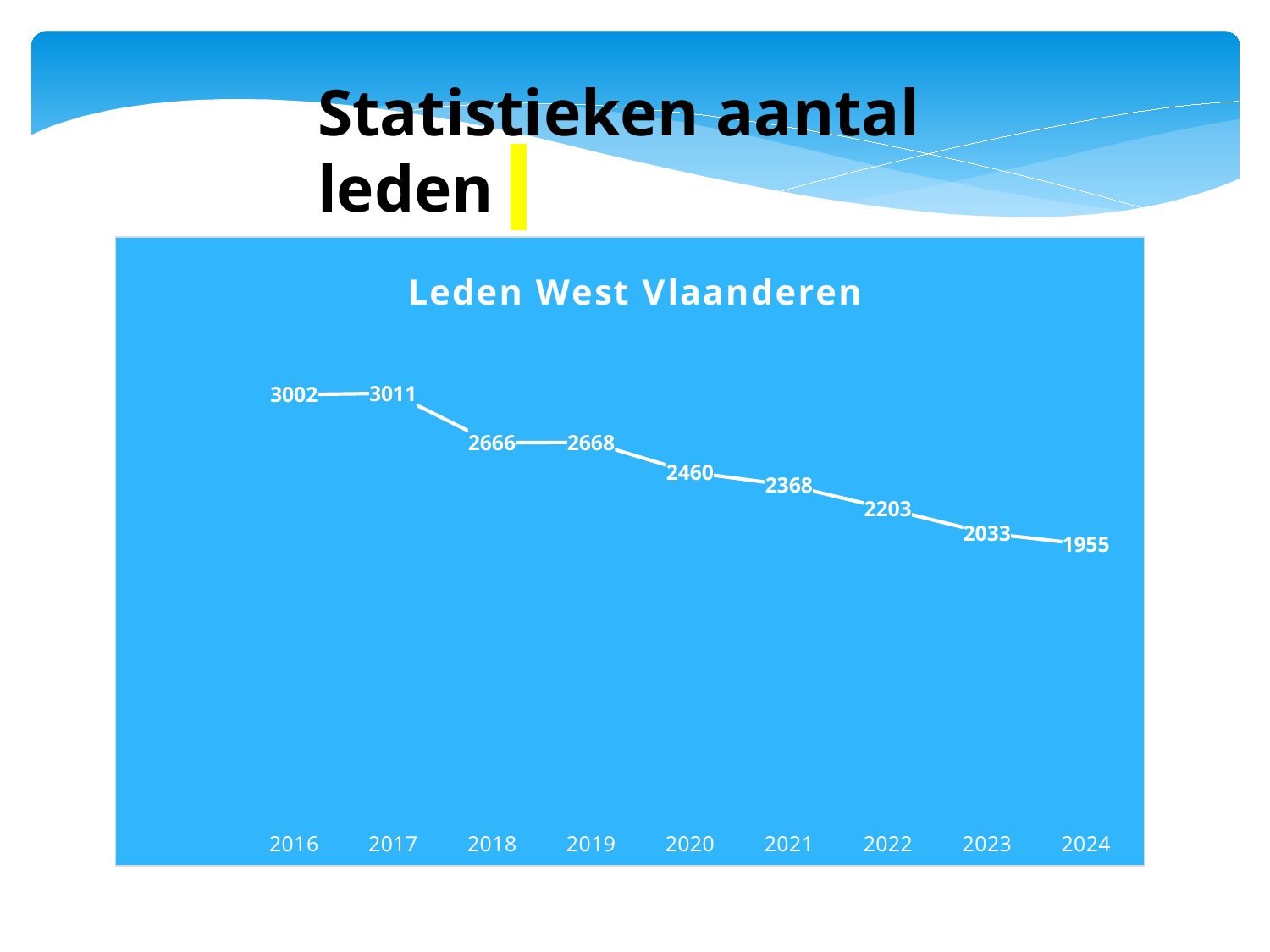
Which year has the lowest value? 2024 What kind of chart is this? line chart How many years are shown on the x axis? 9 What is the difference between the values for 2016 and 2024? 1047 What is the value for 2024? 1955 What is the difference between the values for 2019 and 2020? 208 Which is larger, the value for 2018 or the value for 2019? 2019 What is the value for 2016? 3002 Do the values generally rise or fall from 2016 to 2024? fall What is the value for 2020? 2460 What is the title of the chart? Leden West Vlaanderen Which year has the highest value? 2017